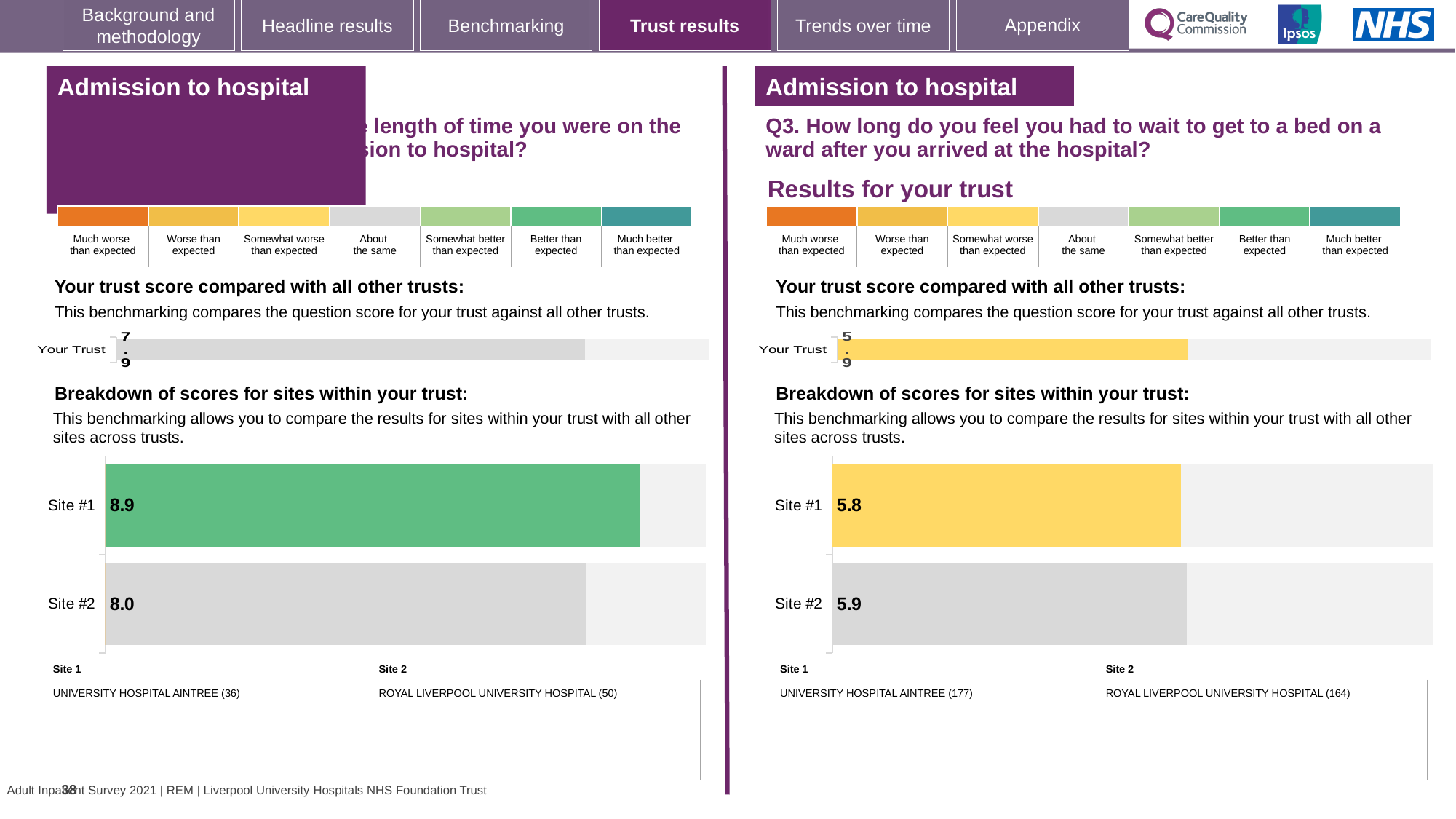
What type of chart is used for the site breakdown on the right-hand (Q3) slide? Bar chart On the right-hand (Q3) slide's site breakdown chart, what is the difference between the Site #2 and Site #1 scores? 0.1 On the right-hand (Q3) slide's site breakdown chart, what colour is the Site #1 bar? Yellow On the left-hand slide's 'Breakdown of scores for sites within your trust' chart, what is the score for Site #1? 8.9 On the right-hand (Q3) slide's 'Breakdown of scores for sites within your trust' chart, what is the score for Site #2? 5.9 On the right-hand (Q3) slide's 'Breakdown of scores for sites within your trust' chart, what is the score for Site #1? 5.8 On the left-hand slide's 'Breakdown of scores for sites within your trust' chart, what is the score for Site #2? 8.0 On the left-hand slide's 'Your trust score compared with all other trusts' chart, what is the score for Your Trust? 7.9 On the left-hand slide's site breakdown chart, what is the difference between the Site #1 and Site #2 scores? 0.9 On the left-hand slide's site breakdown chart, how many sites are shown? 2 On the left-hand slide's site breakdown chart, which site has the higher score? Site #1 On the right-hand (Q3) slide's 'Your trust score compared with all other trusts' chart, what is the score for Your Trust? 5.9